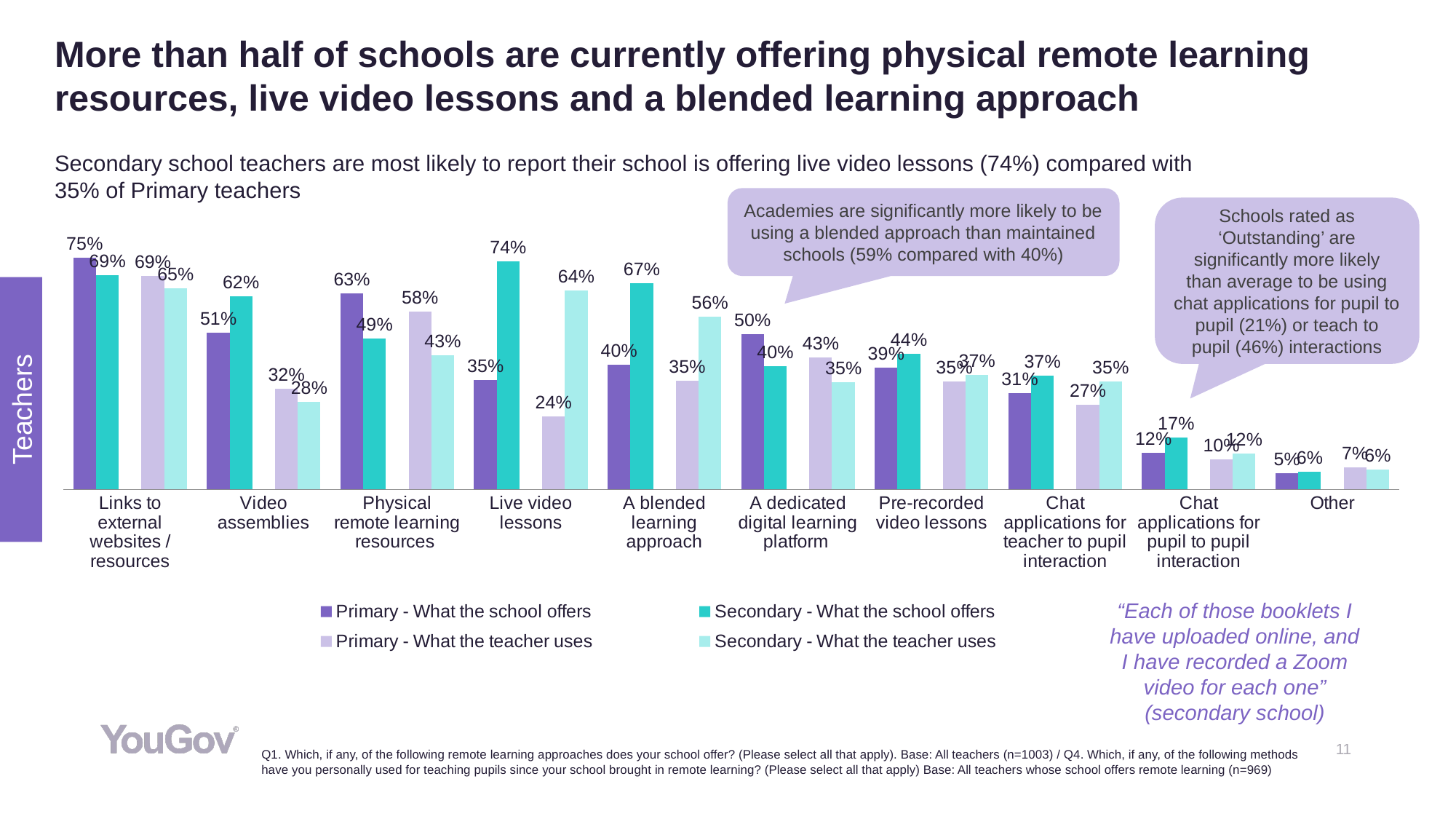
How many categories are shown on the x axis of the chart? 10 What is the difference between the Secondary and Primary 'What the school offers' values for live video lessons? 39 percentage points What type of chart is shown on the slide? Bar chart What is the difference between Primary - What the school offers and Primary - What the teacher uses for a dedicated digital learning platform? 7 percentage points What percentage of Primary teachers report their school offers live video lessons? 35% What is the value for Secondary - What the teacher uses for chat applications for teacher to pupil interaction? 35% Which category has the lowest value for Primary - What the school offers? Other What is the value for Secondary - What the school offers for a blended learning approach? 67% Which category has the highest value for Secondary - What the school offers? Live video lessons How many series does the legend list? 4 For video assemblies, which is larger: Primary - What the school offers or Secondary - What the school offers? Secondary - What the school offers What is the value for Primary - What the teacher uses for physical remote learning resources? 58%